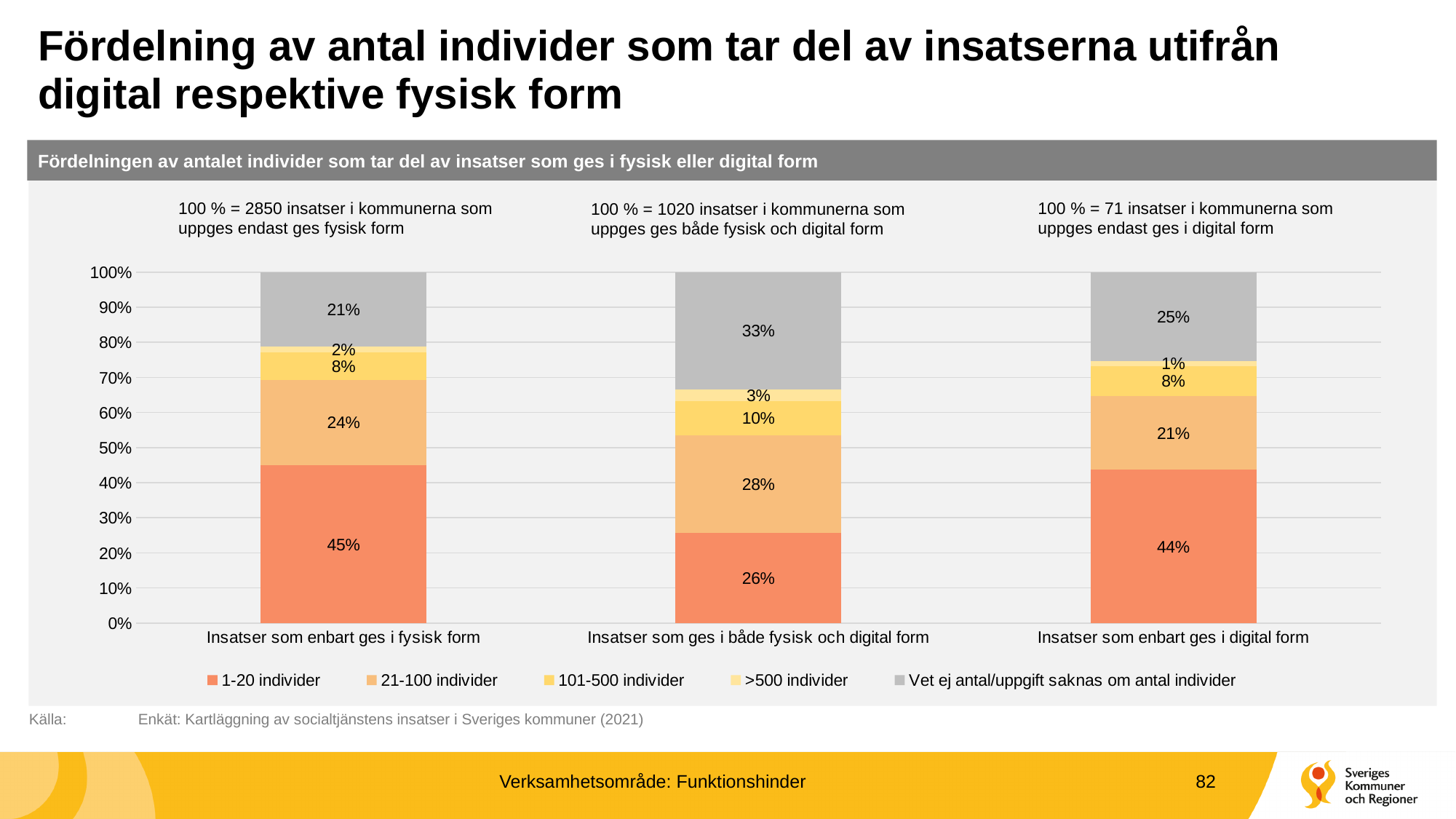
How many categories are shown on the x axis? 3 What share of insatser som ges i både fysisk och digital form fall under 'Vet ej antal/uppgift saknas om antal individer'? 33% What share of insatser som ges i både fysisk och digital form reach >500 individer? 3% Which category has the lowest share for >500 individer? Insatser som enbart ges i digital form What kind of chart is shown on the slide? Stacked bar chart What share of insatser som enbart ges i fysisk form reach 1-20 individer? 45% What share of insatser som enbart ges i digital form reach 21-100 individer? 21% Which category has the highest share for 1-20 individer? Insatser som enbart ges i fysisk form What is the difference between the 1-20 individer share for insatser som enbart ges i fysisk form and for insatser som ges i både fysisk och digital form? 19 percentage points Which is larger: the 21-100 individer share for insatser som ges i både fysisk och digital form or for insatser som enbart ges i fysisk form? Insatser som ges i både fysisk och digital form According to the note above the chart, how many insatser does 100 % correspond to for kommuner som uppges endast ges i digital form? 71 How many series does the legend list? 5